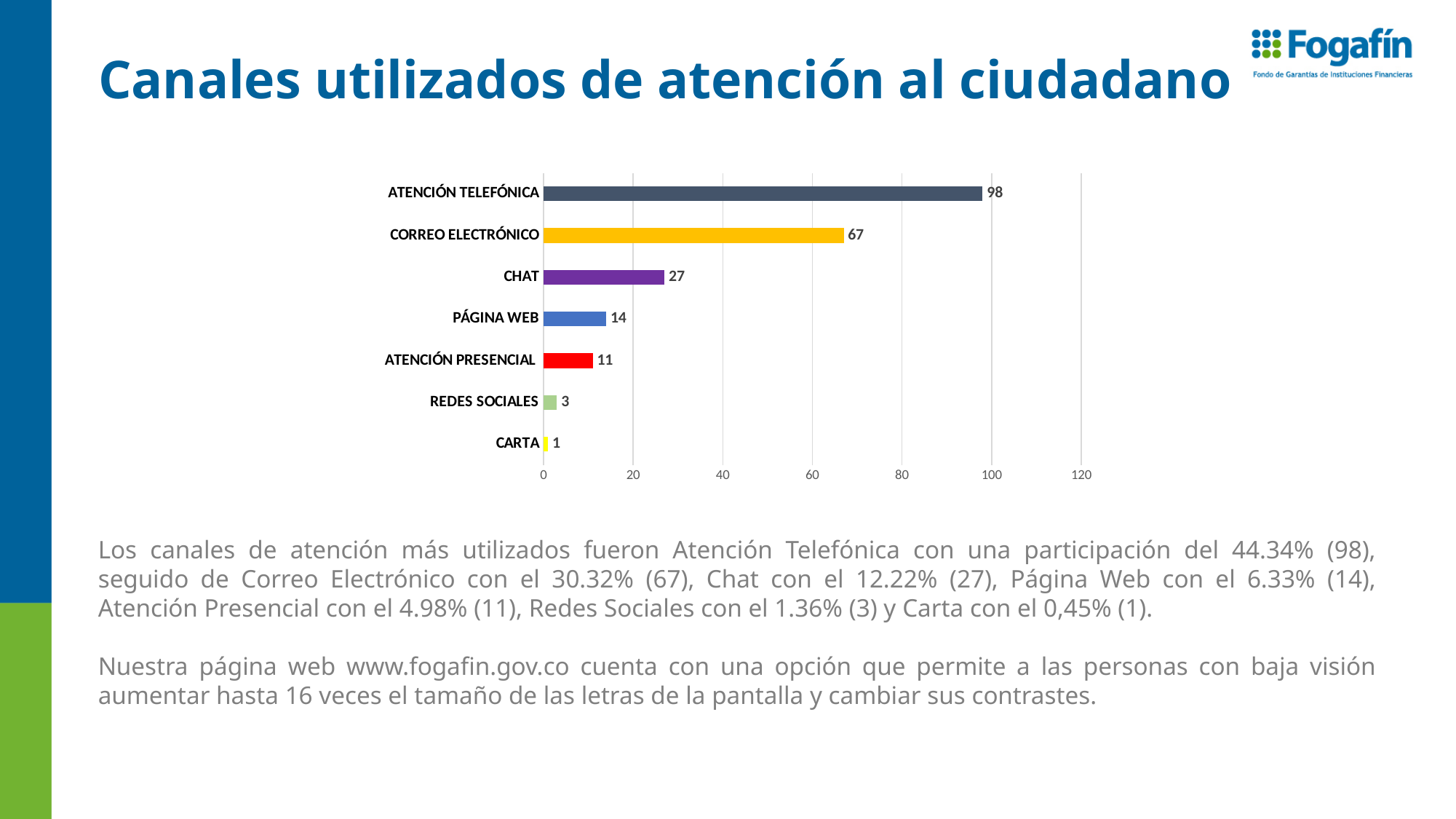
What is the value for PÁGINA WEB? 14 Which category has the highest value? ATENCIÓN TELEFÓNICA What is the value for REDES SOCIALES? 3 What is the value for ATENCIÓN TELEFÓNICA? 98 Which category has the lowest value? CARTA What is the value for CORREO ELECTRÓNICO? 67 What is the difference between the values for CHAT and ATENCIÓN PRESENCIAL? 16 What kind of chart is shown on the slide? bar chart How many categories are shown in the chart? 7 What is the difference between the values for ATENCIÓN TELEFÓNICA and CORREO ELECTRÓNICO? 31 Is the value for CHAT greater or less than 20? greater Which is larger, the value for PÁGINA WEB or the value for ATENCIÓN PRESENCIAL? PÁGINA WEB